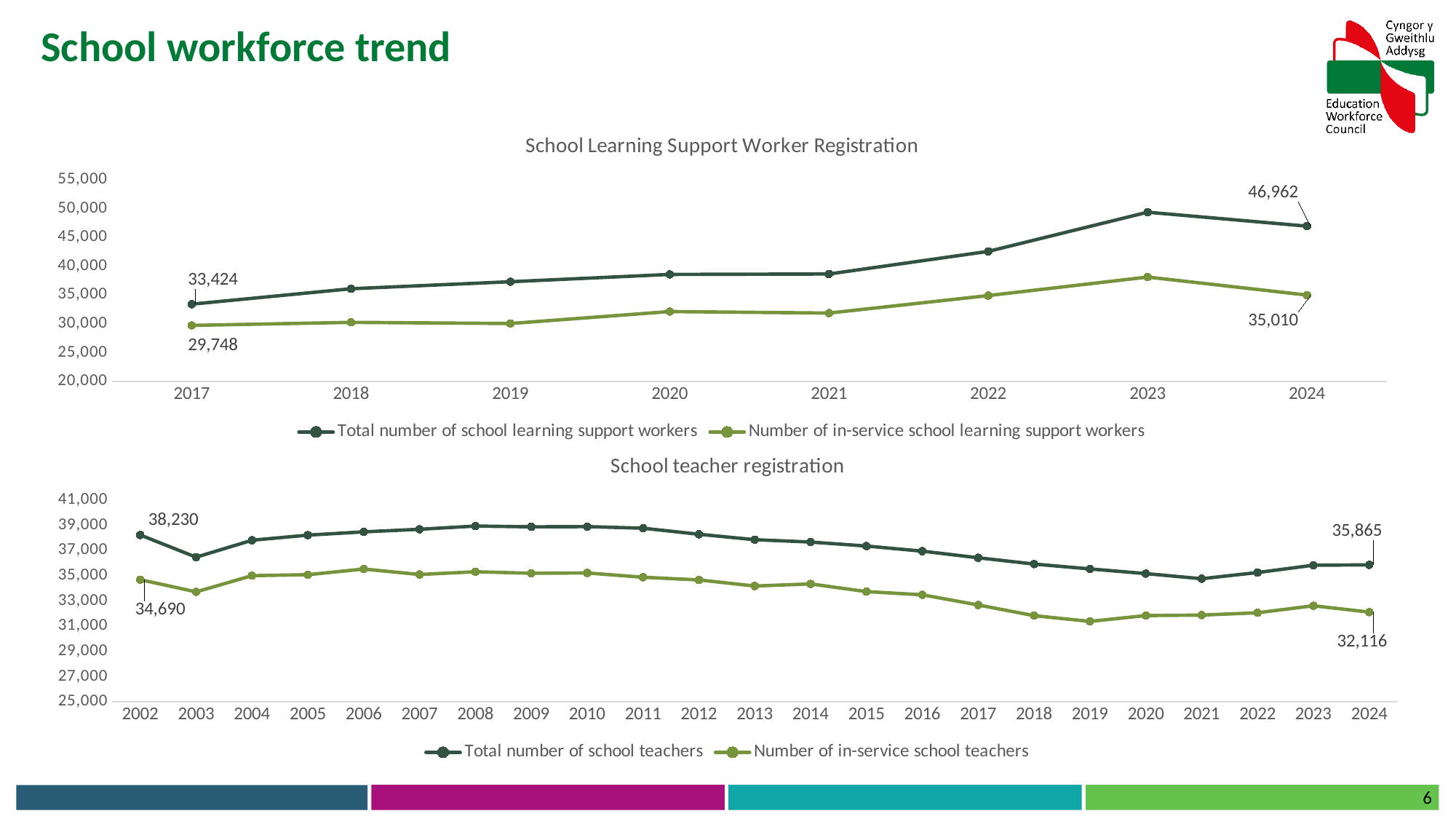
In the School Learning Support Worker Registration chart, by how much did the total number of school learning support workers increase from 2017 to 2024? 13,538 What type of chart is the School teacher registration chart? Line chart In the School teacher registration chart, what is the number of in-service school teachers in 2024? 32,116 How many series does the legend of the School Learning Support Worker Registration chart list? 2 In the School teacher registration chart, which year has the lowest number of in-service school teachers? 2019 How many years are plotted on the x axis of the School teacher registration chart? 23 In the School teacher registration chart, what is the total number of school teachers in 2002? 38,230 In the School teacher registration chart, what is the difference between the total number of school teachers and the number of in-service school teachers in 2024? 3,749 In the School Learning Support Worker Registration chart, what is the total number of school learning support workers in 2024? 46,962 In the School Learning Support Worker Registration chart, is the total number of school learning support workers in 2023 greater or less than 45,000? greater In the School Learning Support Worker Registration chart, what is the number of in-service school learning support workers in 2017? 29,748 In the School Learning Support Worker Registration chart, which year has the highest total number of school learning support workers? 2023